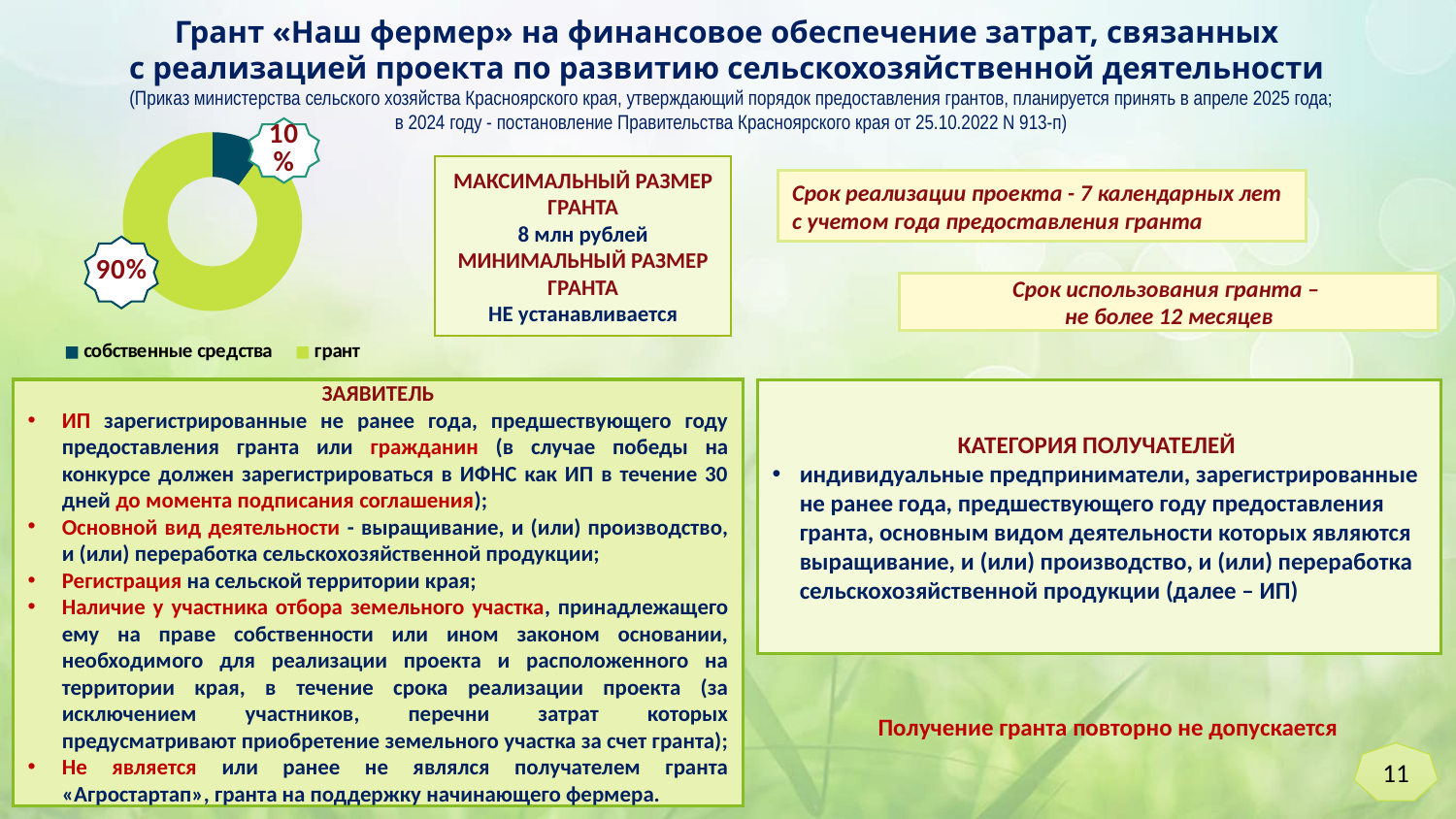
How many entries does the chart legend list? 2 What share of the chart does «грант» represent? 90% What do the two slices of the chart add up to? 100% What kind of chart is shown on the slide? Doughnut (pie) chart Which category has the smallest slice in the chart? собственные средства What is the difference between the «грант» share and the «собственные средства» share? 80% Which legend entry is shown in dark teal? собственные средства Which legend entry is shown in light green? грант Which is larger: the «грант» slice or the «собственные средства» slice? грант How many categories (slices) does the chart have? 2 Which category has the largest slice in the chart? грант What share of the chart does «собственные средства» represent? 10%